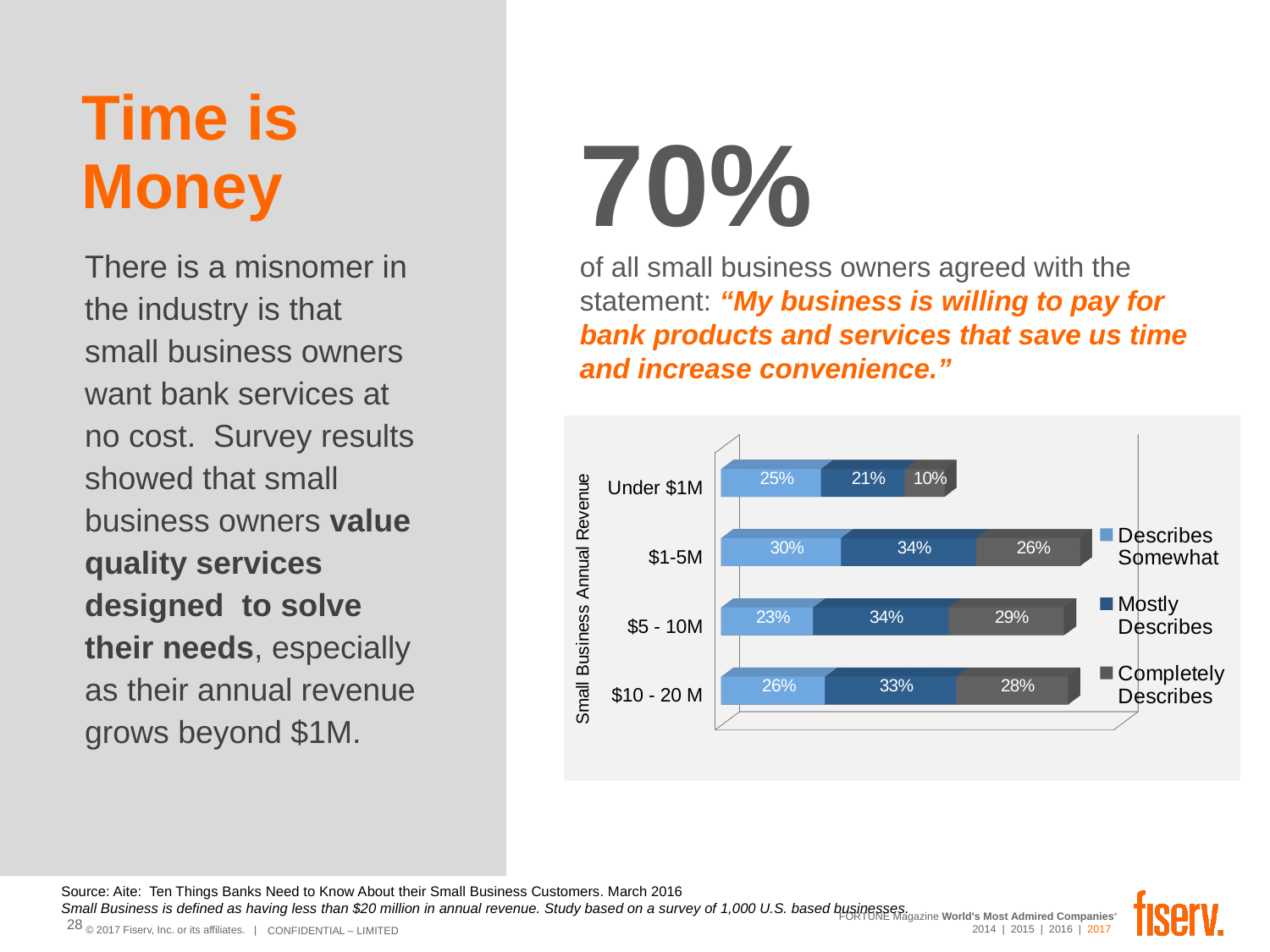
Which is larger: the 'Mostly Describes' value for Under $1M or for $10 - 20 M? $10 - 20 M What is the 'Mostly Describes' value for the $1-5M category? 34% What is the 'Completely Describes' value for the $10 - 20 M category? 28% How many series does the chart legend list? 3 What is the 'Describes Somewhat' value for the $5 - 10M category? 23% What is the 'Completely Describes' value for the Under $1M category? 10% What is the difference between the 'Completely Describes' values for $5 - 10M and Under $1M? 19% What kind of chart is shown on the slide? Stacked bar chart Which revenue category has the lowest 'Completely Describes' value? Under $1M Which revenue category has the highest 'Describes Somewhat' value? $1-5M What is the total of the stacked bar for the Under $1M category? 56% How many revenue categories are plotted in the chart? 4